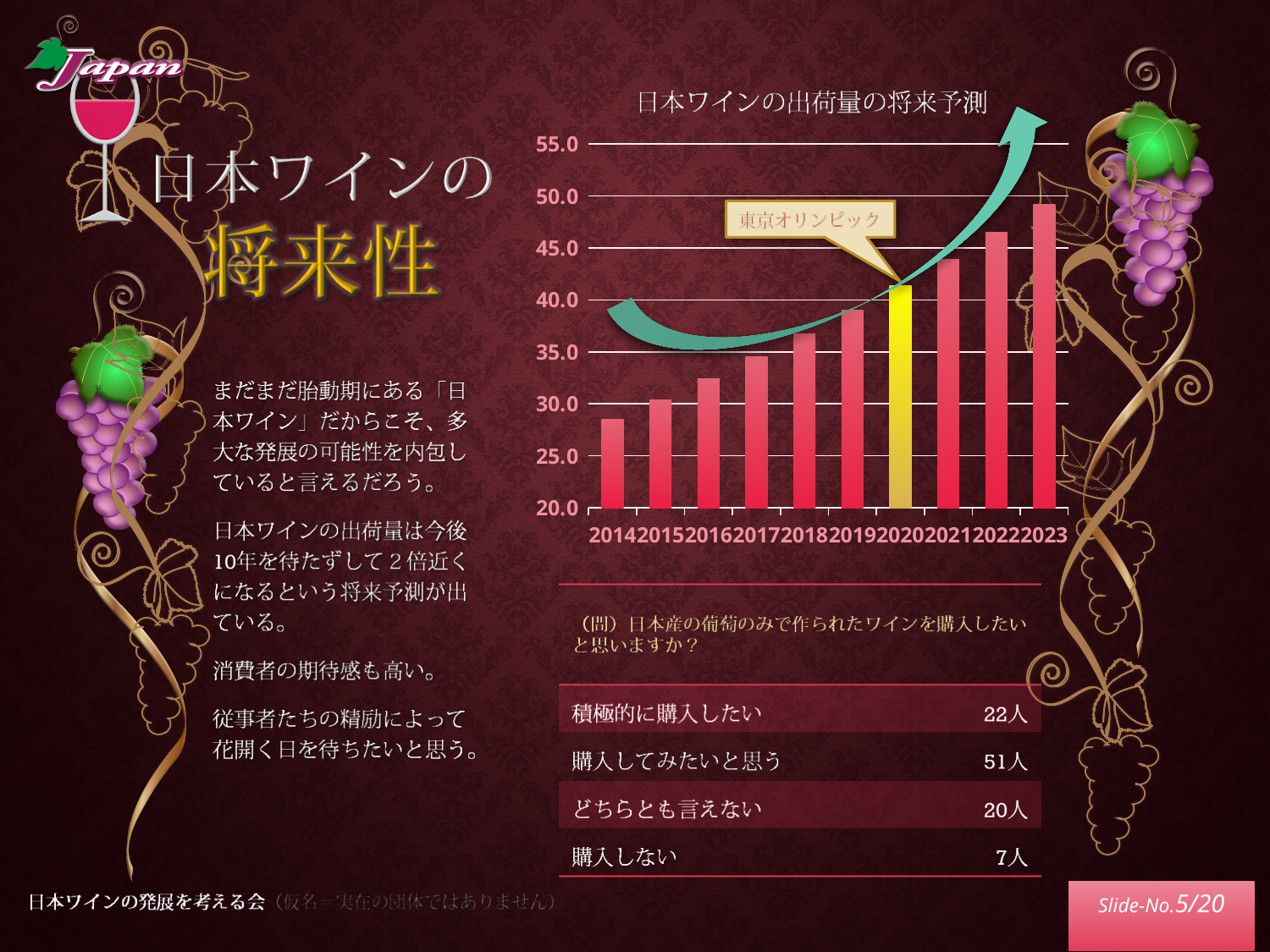
Do the values rise or fall from 2014 to 2023? rise Is the value for 2014 greater or less than 30.0? less How many years are plotted on the x axis of the chart? 10 Which year's bar is highlighted in yellow with the callout 東京オリンピック? 2020 What is the title of the chart? 日本ワインの出荷量の将来予測 What kind of chart is shown on the slide? bar chart Is the value for 2023 greater or less than 45.0? greater Is the value for 2020 greater or less than 40.0? greater Which year has the lowest bar in the chart? 2014 Which is larger, the value for 2018 or the value for 2021? 2021 Which year has the highest bar in the chart? 2023